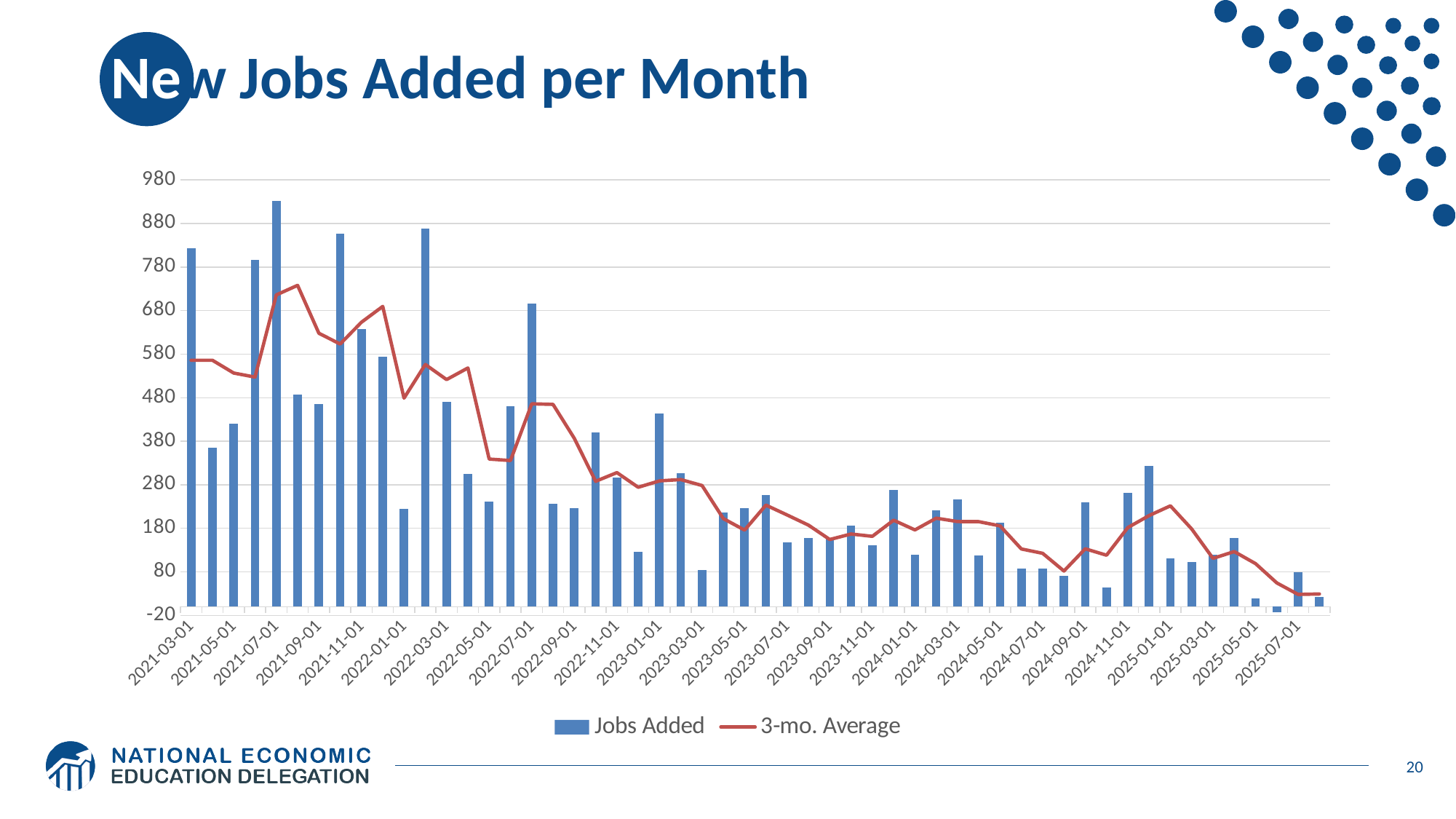
Is the Jobs Added value for 2023-03-01 greater or less than 180? less What are the two series named in the legend? Jobs Added and 3-mo. Average Overall, do the Jobs Added values rise or fall from 2021-03-01 to 2025-07-01? Fall What kind of chart is shown on the slide? Bar chart with a line overlay How many series does the legend list? 2 What colour is the 3-mo. Average line? Red Is the Jobs Added value for 2021-03-01 greater or less than 780? greater Which month has the highest Jobs Added bar? 2021-07-01 Is the Jobs Added value for 2025-05-01 greater or less than 80? less Which has the larger Jobs Added value, 2023-01-01 or 2023-03-01? 2023-01-01